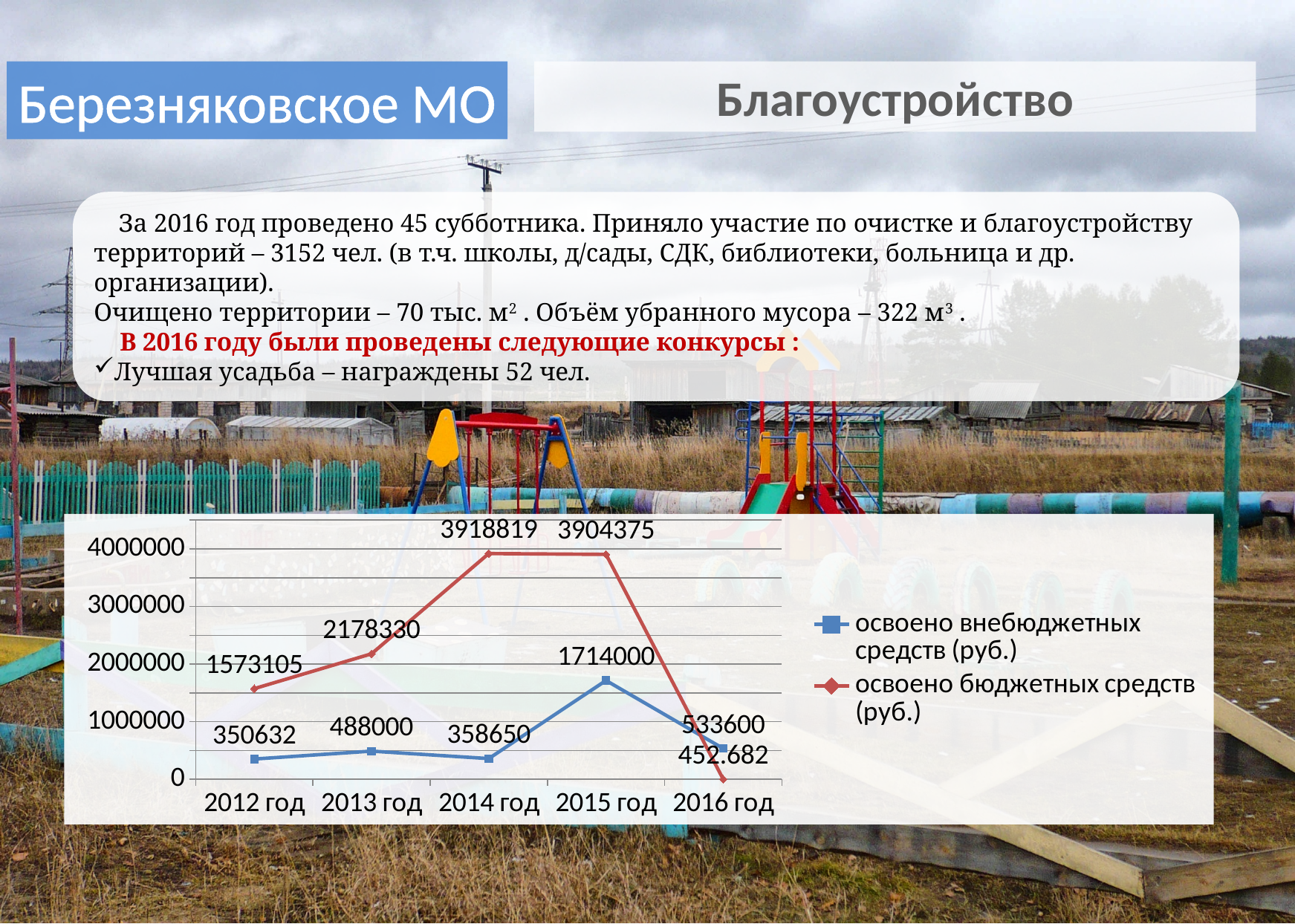
What is the value of освоено внебюджетных средств (руб.) for 2012 год? 350632 How many series does the chart legend list? 2 In which year is освоено внебюджетных средств (руб.) the lowest? 2012 год How many years are plotted along the x axis of the chart? 5 In which year is освоено внебюджетных средств (руб.) the highest? 2015 год What is the value of освоено внебюджетных средств (руб.) for 2015 год? 1714000 What is the value of освоено бюджетных средств (руб.) for 2014 год? 3918819 What is the difference between освоено внебюджетных средств (руб.) in 2015 год and 2016 год? 1180400 What type of chart is shown on the slide? line chart Does освоено бюджетных средств (руб.) rise or fall from 2012 год to 2014 год? rise Which is larger: освоено бюджетных средств (руб.) in 2013 год or освоено внебюджетных средств (руб.) in 2013 год? освоено бюджетных средств (руб.) Is the value of освоено внебюджетных средств (руб.) for 2015 год greater or less than 1000000? greater